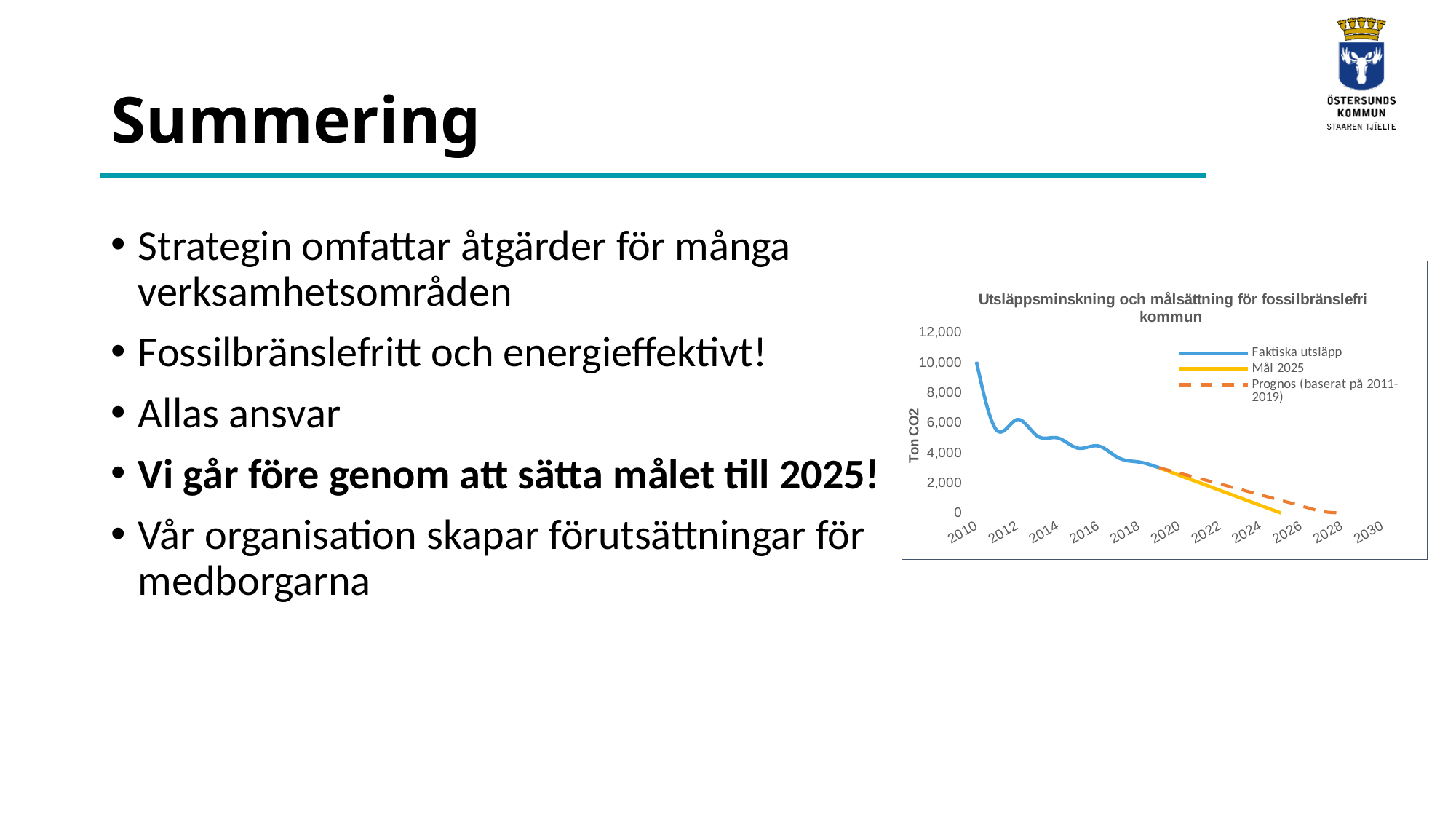
Is the value of Faktiska utsläpp in 2010 larger or smaller than in 2018? larger What kind of chart is shown on the slide? line chart Which series reaches 0 first along the x axis, Mål 2025 or Prognos (baserat på 2011-2019)? Mål 2025 Do the values of the Faktiska utsläpp series rise or fall from 2010 to 2019? fall What is the title of the chart? Utsläppsminskning och målsättning för fossilbränslefri kommun Is the value of Faktiska utsläpp in 2018 greater or less than 4,000? less Is the value of Faktiska utsläpp in 2014 greater or less than 8,000? less Is the value of Faktiska utsläpp in 2012 greater or less than 4,000? greater Which year has the highest value of Faktiska utsläpp? 2010 How many series does the chart's legend list? 3 What is the label on the chart's vertical axis? Ton CO2